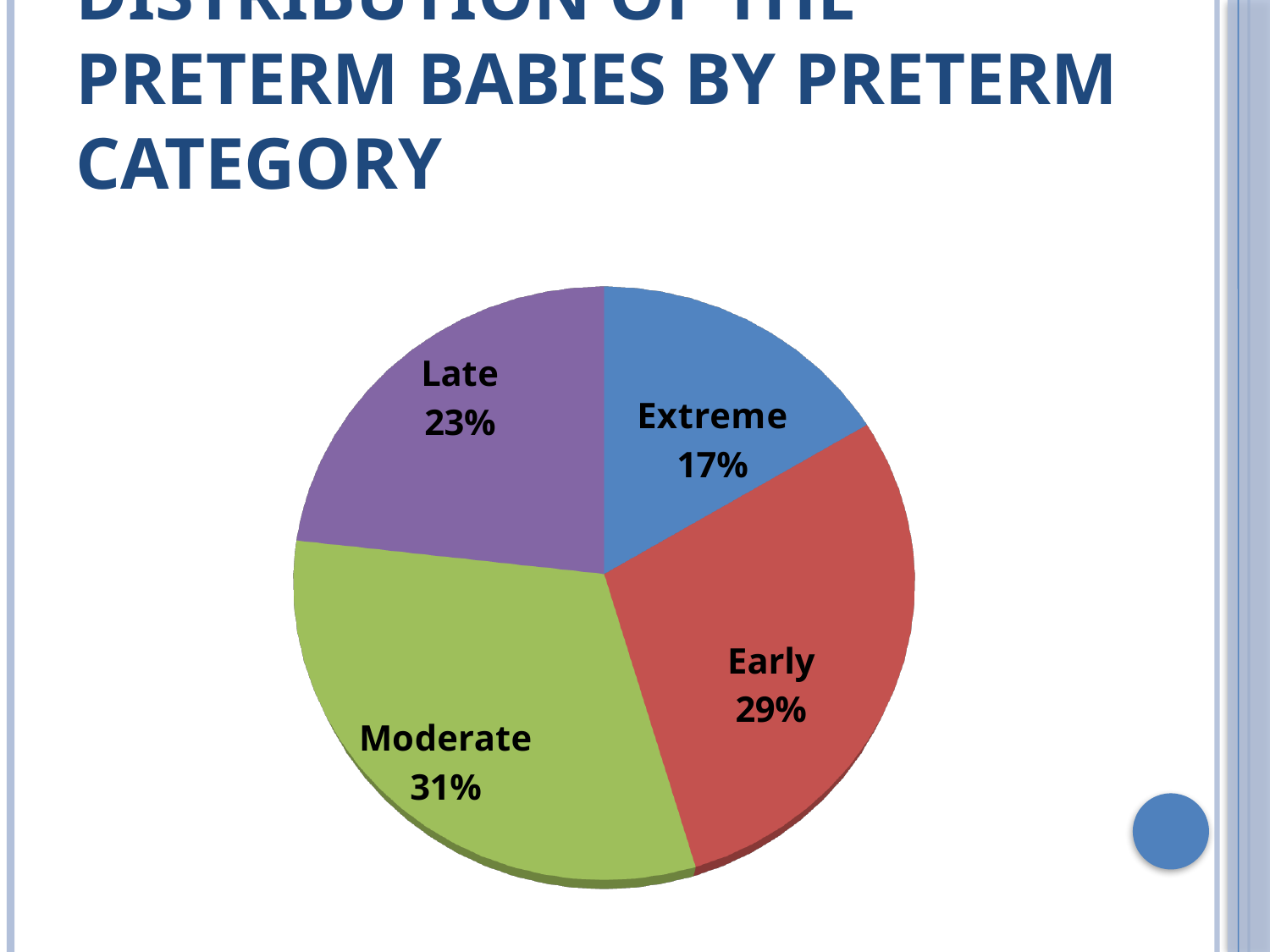
Which category has a larger share, Late or Extreme? Late What type of chart is shown on the slide? Pie chart What percentage of preterm babies are in the Extreme category? 17% What is the difference in percentage points between the Early and Late categories? 6 What percentage of preterm babies are in the Moderate category? 31% What percentage of preterm babies are in the Early category? 29% What percentage of preterm babies are in the Late category? 23% How many preterm categories are shown in the pie chart? 4 What is the difference in percentage points between the Moderate and Extreme categories? 14 Which preterm category has the smallest share of the pie? Extreme What colour is the slice for the Moderate category? Green Which preterm category has the largest share of the pie? Moderate